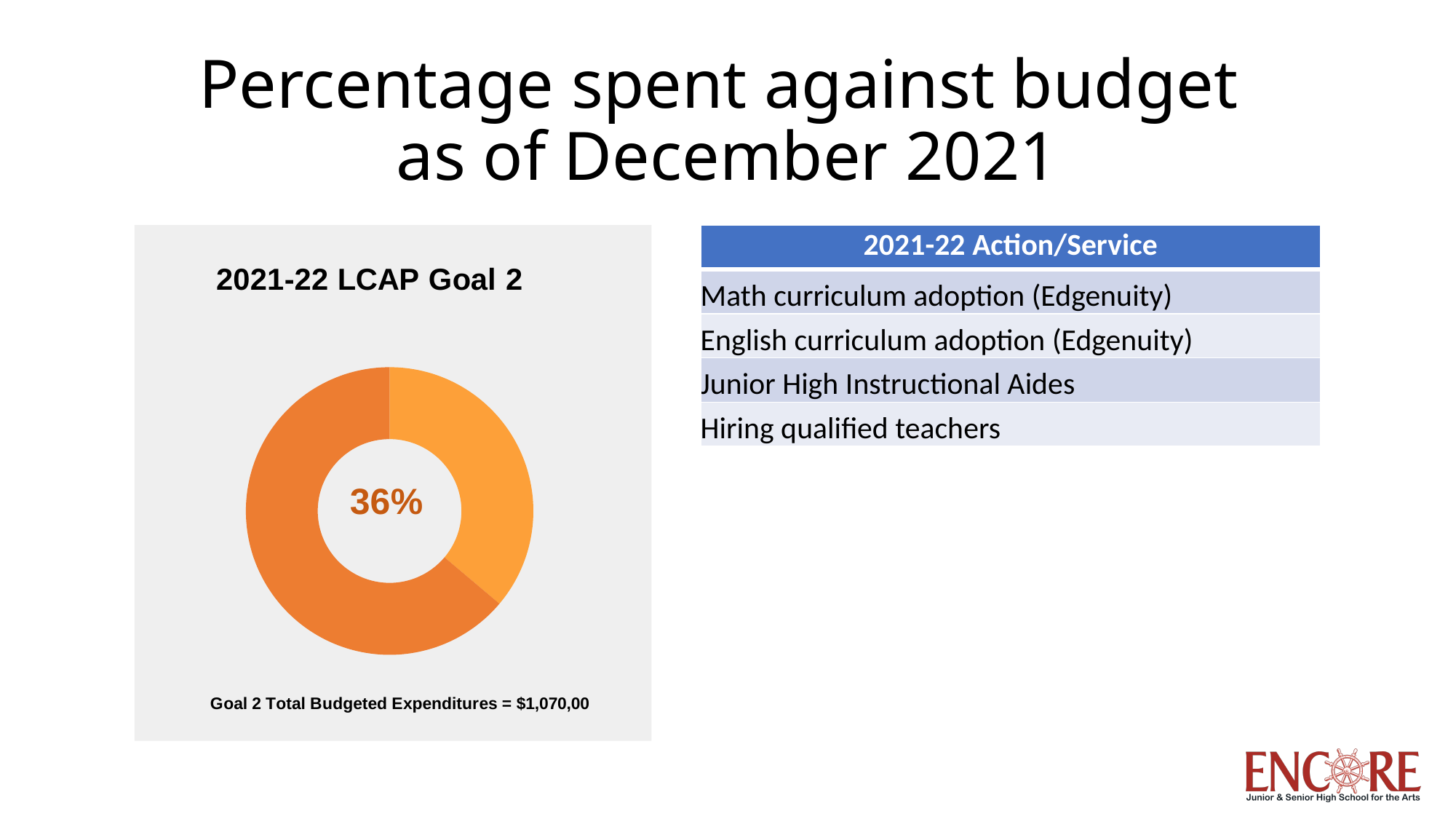
How many slices does the doughnut chart have? 2 Does the doughnut chart include a legend? No What kind of chart is shown on the slide? Doughnut chart Is the percentage spent shown in the doughnut chart greater or less than 50%? less What percentage of the Goal 2 budget had been spent as of December 2021? 36% What percentage is shown in the center of the doughnut chart? 36% What is the Goal 2 Total Budgeted Expenditures figure printed below the chart? $1,070,00 What is the title of the chart on the slide? 2021-22 LCAP Goal 2 What share of the doughnut does the lighter orange slice represent? 36% Which slice of the doughnut chart is larger, the lighter orange slice or the darker orange slice? The darker orange slice